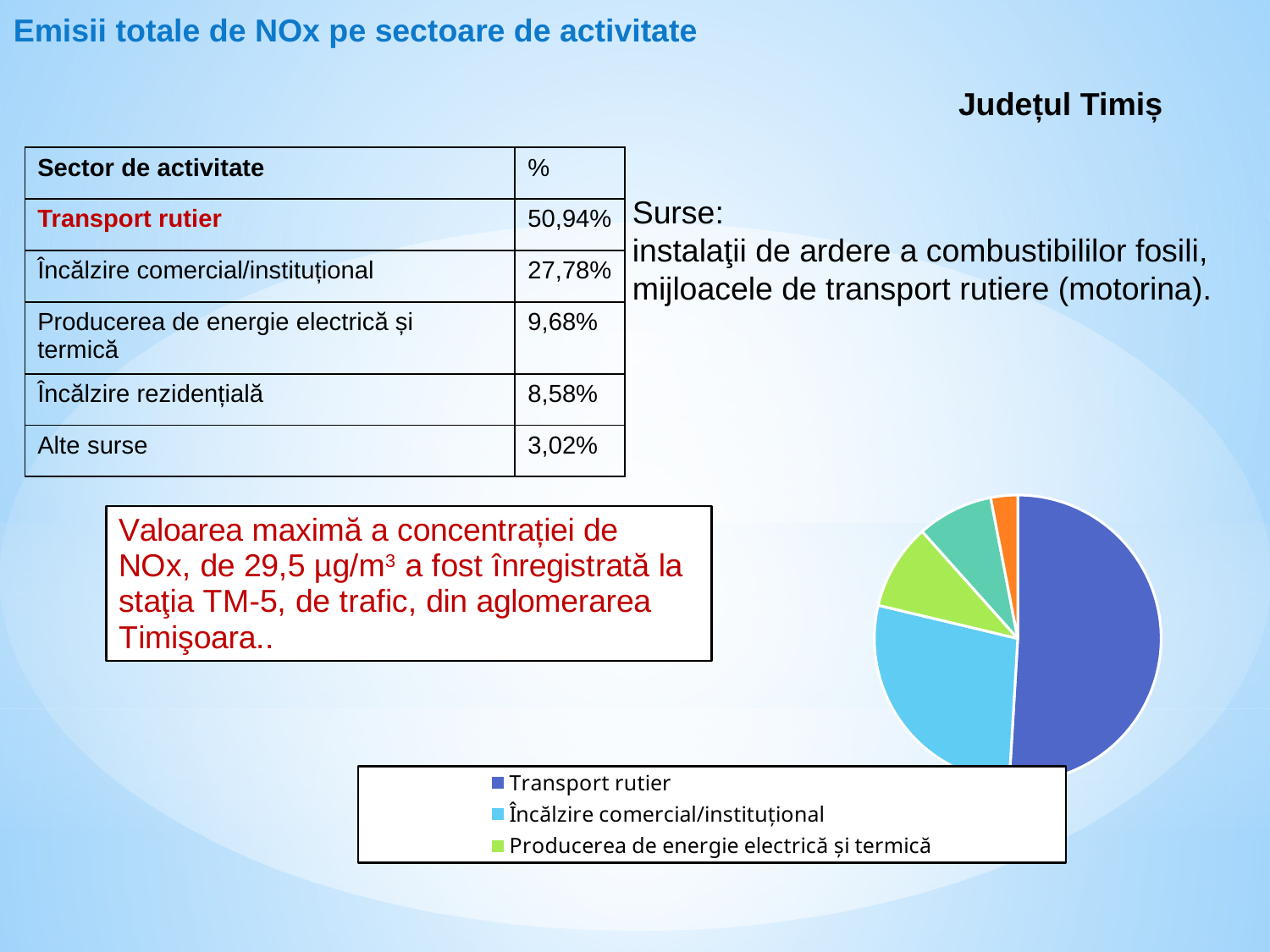
What kind of chart is shown on the slide? Pie chart What share of total NOx emissions does Producerea de energie electrică și termică account for? 9,68% What share of total NOx emissions does Încălzire comercial/instituțional account for? 27,78% What colour represents Încălzire comercial/instituțional in the pie chart? Light blue What colour represents Transport rutier in the pie chart? Dark blue Which is larger in the pie chart: Transport rutier or Încălzire comercial/instituțional? Transport rutier Of the three sectors listed in the legend, which has the smallest share? Producerea de energie electrică și termică Which sector has the largest slice in the pie chart? Transport rutier What share of total NOx emissions does Transport rutier account for? 50,94% How many entries does the pie chart's legend list? 3 How many slices does the pie chart have? 5 What is the difference in percentage points between Transport rutier and Încălzire comercial/instituțional? 23,16%